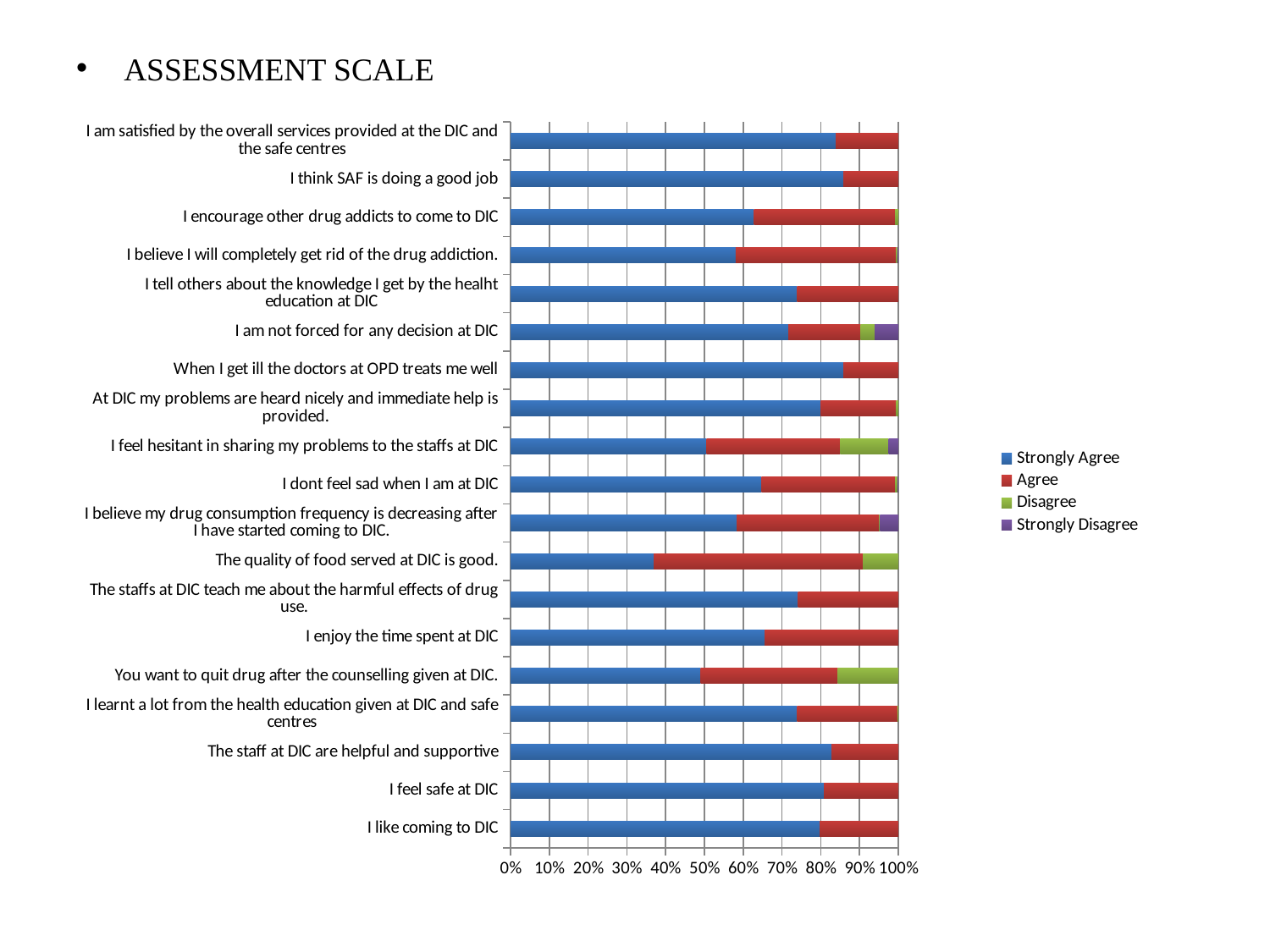
How many statements (categories) are plotted on the chart? 19 What kind of chart is shown on the slide? Stacked bar chart Which has the larger Strongly Agree share: 'I like coming to DIC' or 'The quality of food served at DIC is good.'? I like coming to DIC Which statement has the smallest Strongly Agree share? The quality of food served at DIC is good. What is the total of each stacked bar on the chart? 100% Is the Strongly Agree share for 'I think SAF is doing a good job' greater or less than 80%? greater Which series is shown in purple in the legend? Strongly Disagree Is the Strongly Agree share for 'You want to quit drug after the counselling given at DIC.' greater or less than 40%? greater Is the Strongly Agree share for 'The quality of food served at DIC is good.' greater or less than 40%? less How many series does the legend list? 4 How many statements show a Strongly Disagree segment? 3 Which series is shown in blue in the legend? Strongly Agree